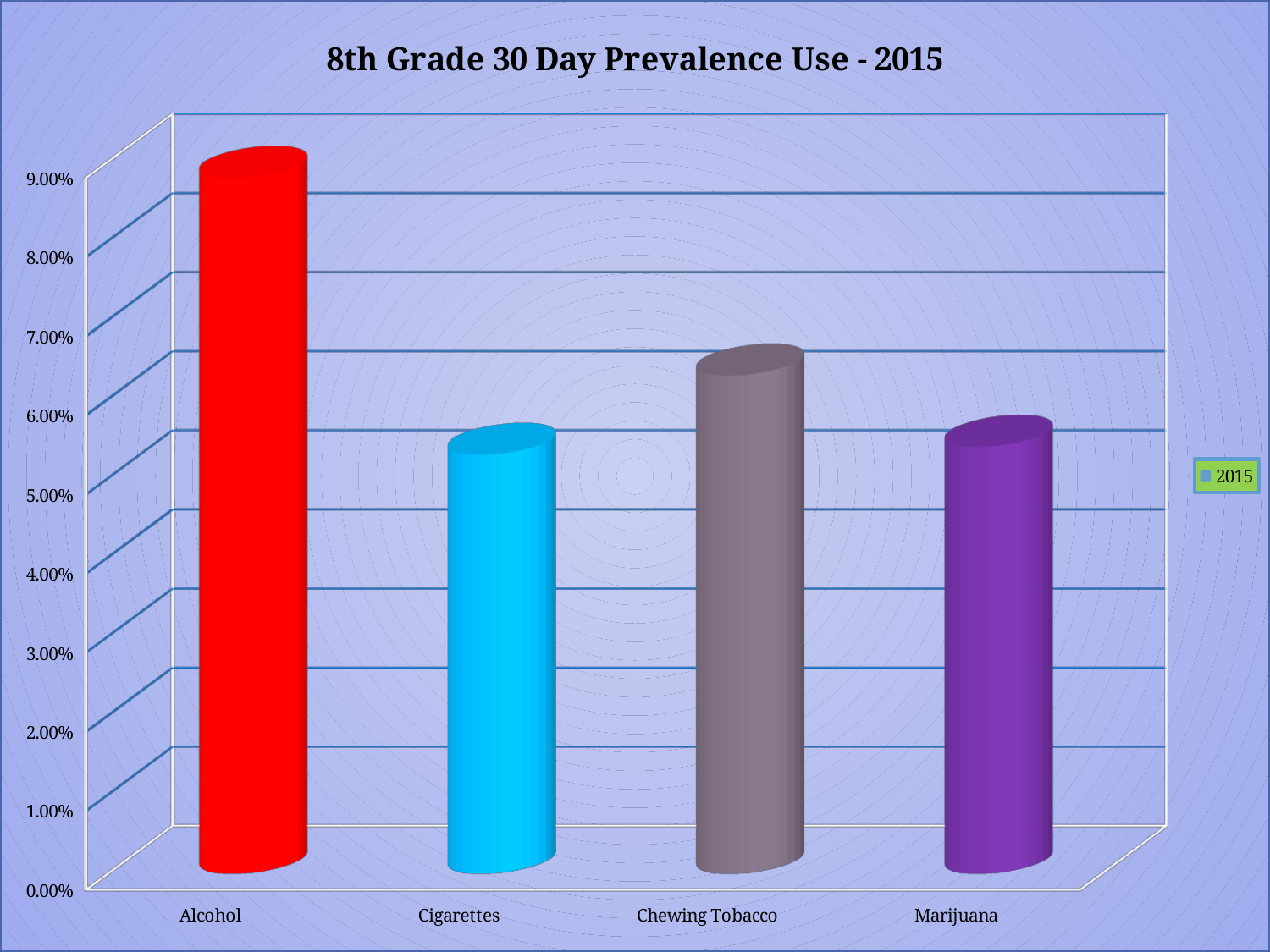
Which category has the highest value in the chart? Alcohol Which is larger, the value for Alcohol or the value for Chewing Tobacco? Alcohol How many categories are shown on the x axis of the chart? 4 What entry does the legend show? 2015 Is the value for Cigarettes greater or less than 7.00%? less What is the title of the chart? 8th Grade 30 Day Prevalence Use - 2015 Is the value for Alcohol greater or less than 8.00%? greater How many series does the legend list? 1 Is the value for Chewing Tobacco greater or less than 6.00%? greater Which is larger, the value for Chewing Tobacco or the value for Cigarettes? Chewing Tobacco What kind of chart is shown on the slide? bar chart